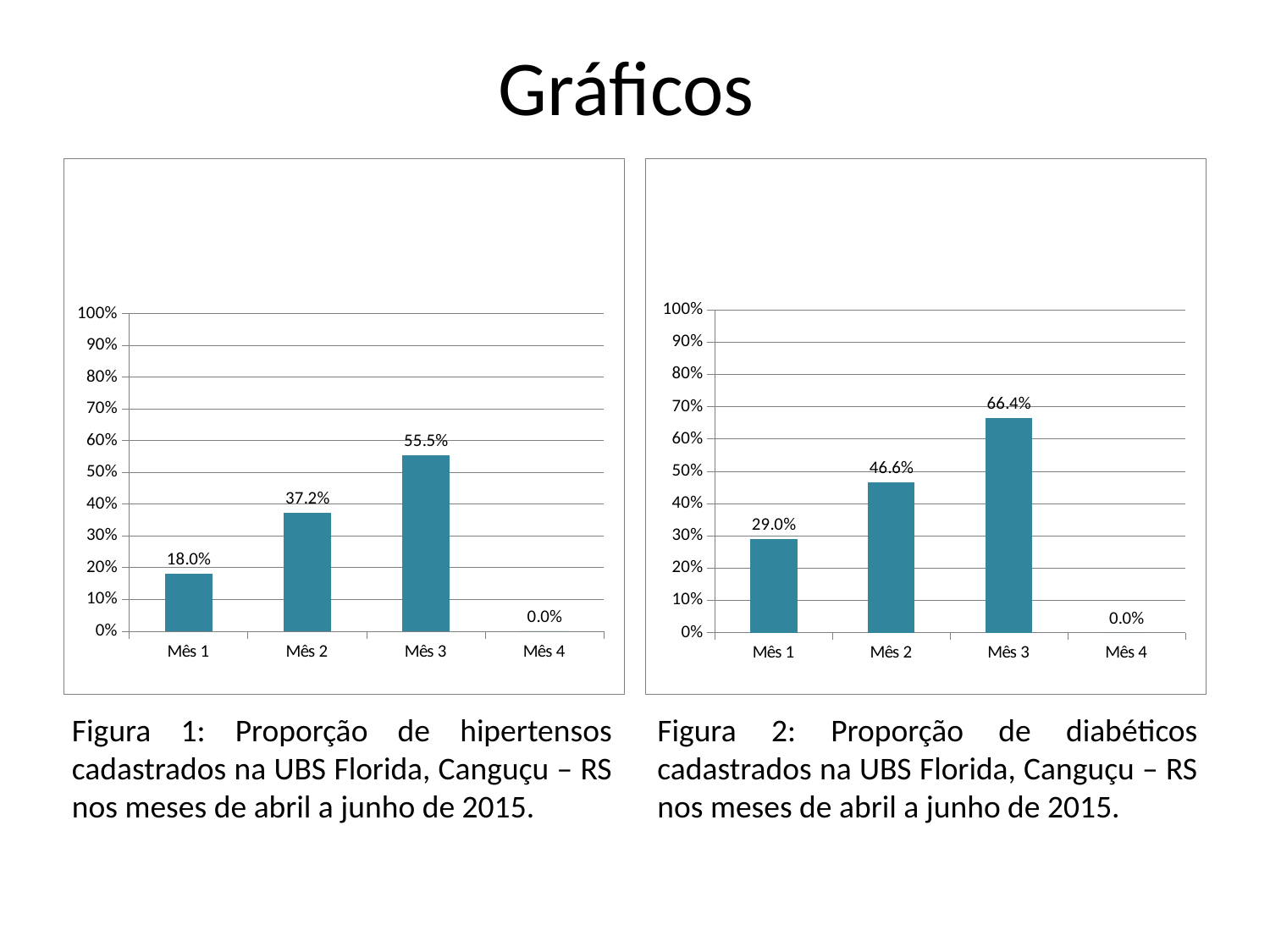
In the right chart (Figura 2, diabéticos), what is the difference between the values for Mês 2 and Mês 1? 17.6% How many months are shown on the x axis of the left chart (Figura 1, hipertensos)? 4 In the right chart (Figura 2, diabéticos), what is the value for Mês 3? 66.4% In the left chart (Figura 1, hipertensos), do the values rise or fall from Mês 1 to Mês 3? rise What kind of chart is the right chart (Figura 2, diabéticos)? bar chart In the right chart (Figura 2, diabéticos), is the value for Mês 2 greater or less than 40%? greater In the left chart (Figura 1, hipertensos), what is the difference between the values for Mês 3 and Mês 1? 37.5% What is the value for Mês 4 in the left chart (Figura 1, hipertensos)? 0.0% In the left chart (Figura 1, hipertensos), which month has the highest value? Mês 3 In the left chart (Figura 1, hipertensos), what is the value for Mês 2? 37.2% In the right chart (Figura 2, diabéticos), which month has the lowest value? Mês 4 Which is larger: the value for Mês 1 in the left chart (Figura 1) or the value for Mês 1 in the right chart (Figura 2)? Mês 1 in the right chart (Figura 2)